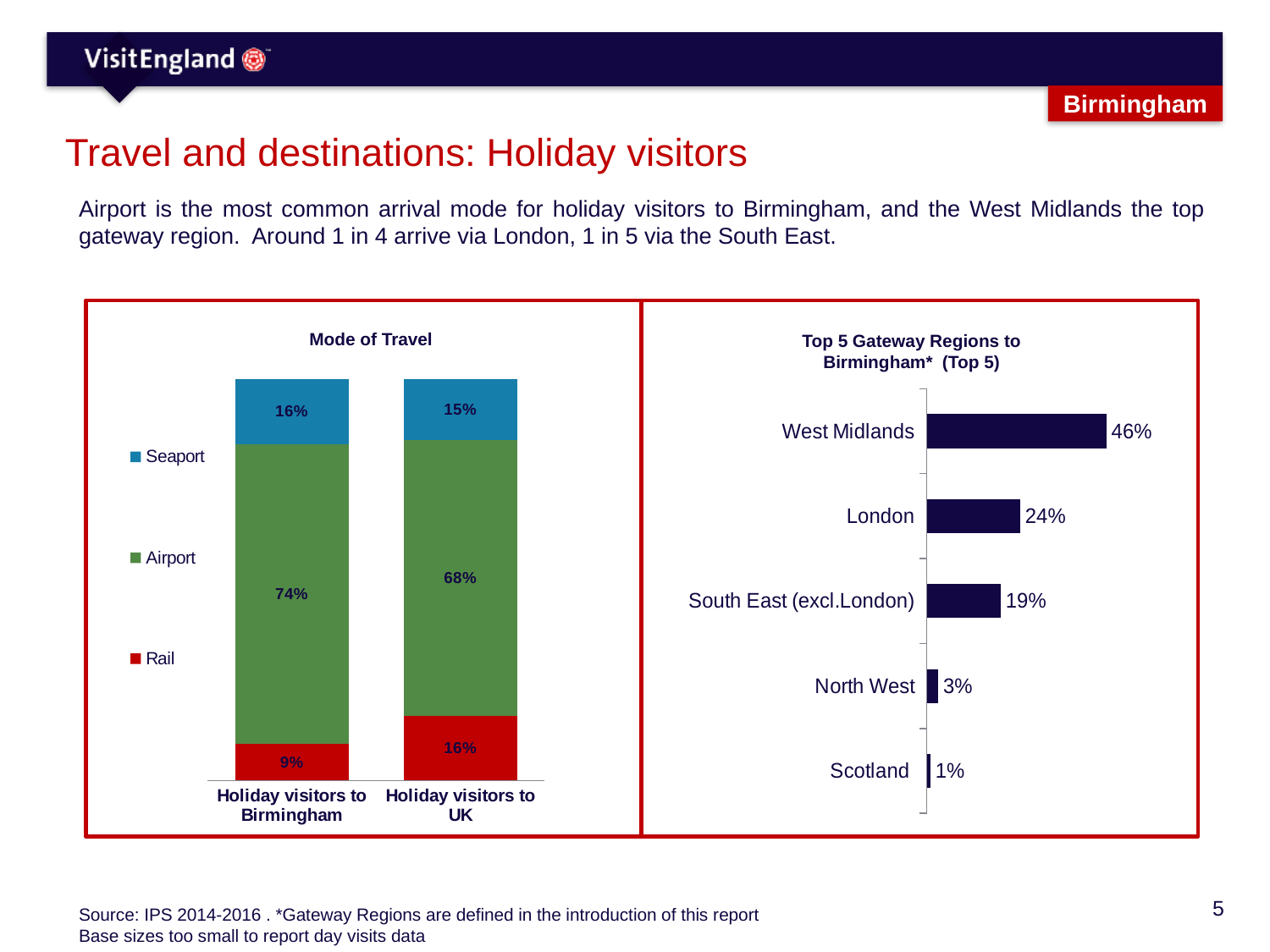
In the 'Mode of Travel' chart, what is the difference between the Airport share for holiday visitors to Birmingham and for holiday visitors to the UK? 6 percentage points In the 'Mode of Travel' chart, what percentage of holiday visitors to the UK arrive by Rail? 16% In the 'Top 5 Gateway Regions to Birmingham' chart, which region has the lowest value? Scotland In the 'Mode of Travel' chart, what is the Seaport share for holiday visitors to Birmingham? 16% In the 'Top 5 Gateway Regions to Birmingham' chart, which region has the highest value? West Midlands In the 'Mode of Travel' chart, how many series does the legend list? 3 In the 'Mode of Travel' chart, which is larger: the Rail share for holiday visitors to Birmingham or for holiday visitors to the UK? Holiday visitors to UK In the 'Top 5 Gateway Regions to Birmingham' chart, what is the difference between West Midlands and South East (excl.London)? 27 percentage points In the 'Mode of Travel' chart, what is the total of the stacked bar for holiday visitors to Birmingham? 99% In the 'Top 5 Gateway Regions to Birmingham' chart, what is the value for London? 24% In the 'Mode of Travel' chart, what percentage of holiday visitors to Birmingham arrive by Airport? 74% What kind of chart is the 'Top 5 Gateway Regions to Birmingham' chart? Bar chart